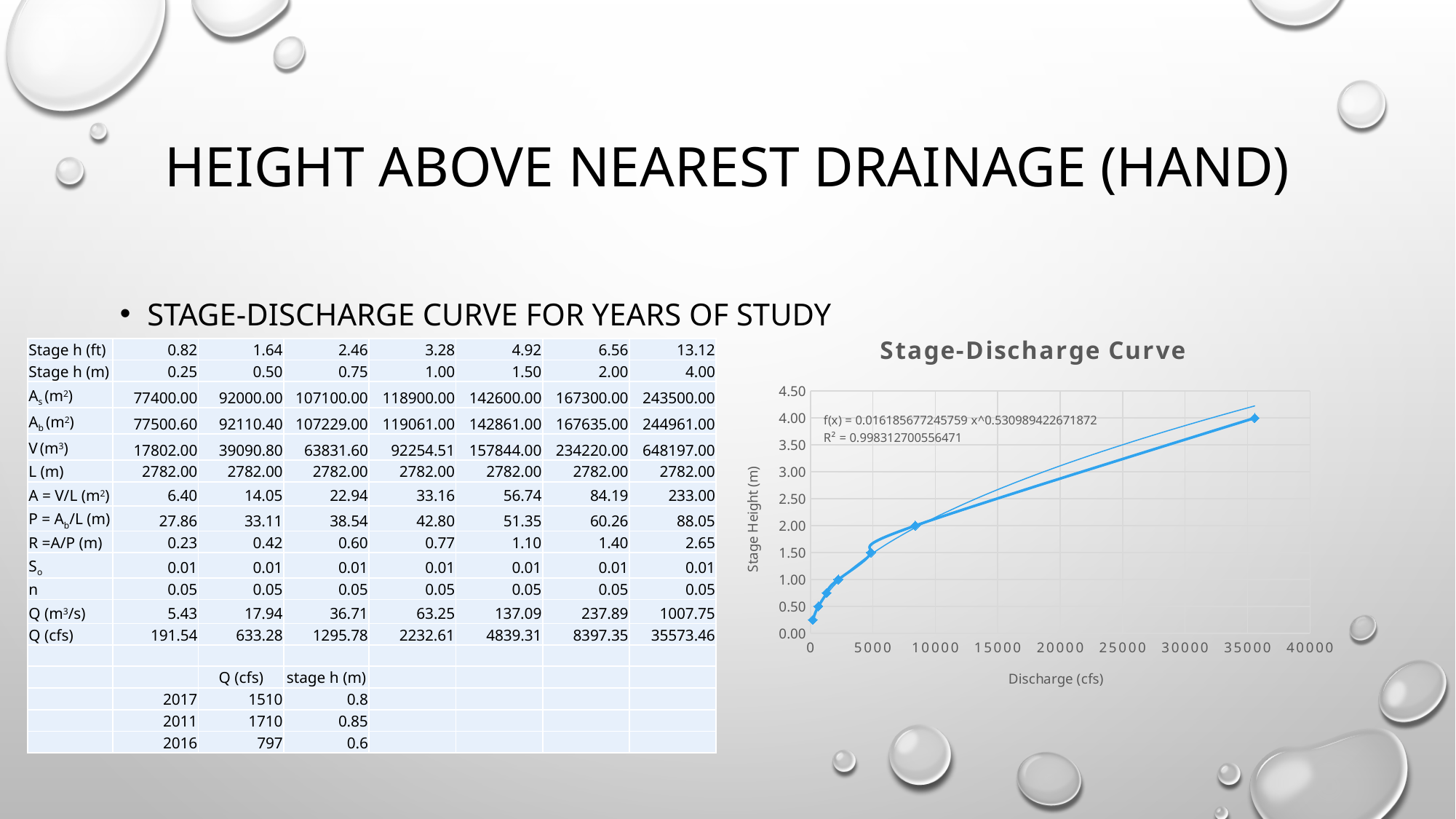
What is the title of the chart on the slide? Stage-Discharge Curve Is the stage height of the lowest plotted point on the Stage-Discharge Curve greater or less than 0.50? less Is the discharge of the point at stage height 2.00 on the Stage-Discharge Curve greater or less than 10000? less What is the label of the y axis on the Stage-Discharge Curve? Stage Height (m) What R² value is printed on the Stage-Discharge Curve? 0.998312700556471 What is the stage height of the highest plotted point on the Stage-Discharge Curve? 4.00 How many data points are plotted on the Stage-Discharge Curve? 7 Does the stage height rise or fall as discharge increases along the x axis of the Stage-Discharge Curve? rises Is the discharge of the highest plotted point on the Stage-Discharge Curve greater or less than 30000? greater What is the maximum value shown on the y axis of the Stage-Discharge Curve? 4.50 What kind of chart is the Stage-Discharge Curve? scatter chart with a line